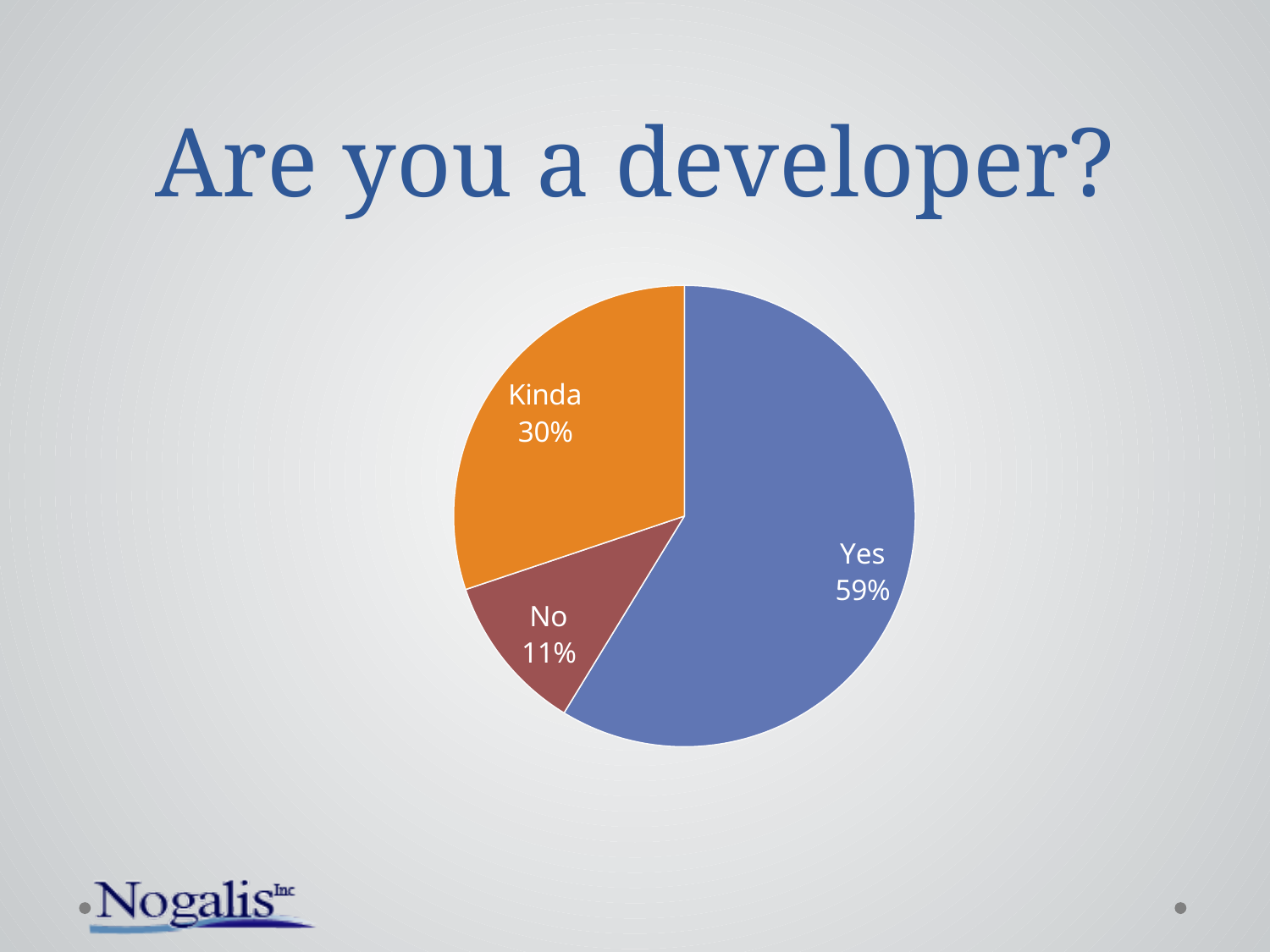
What is the difference in percentage points between "Kinda" and "No"? 19 Which response has the largest share of the pie? Yes What percentage of respondents answered "No"? 11% What percentage of respondents answered "Kinda"? 30% What is the title of the slide containing the pie chart? Are you a developer? Which response has the smallest share of the pie? No Which is larger, the share for "Kinda" or the share for "No"? Kinda What kind of chart is shown on the slide? Pie chart What percentage of respondents answered "Yes"? 59% What is the difference in percentage points between "Yes" and "Kinda"? 29 How many slices does the pie chart have? 3 What colour is the "Yes" slice of the pie chart? Blue